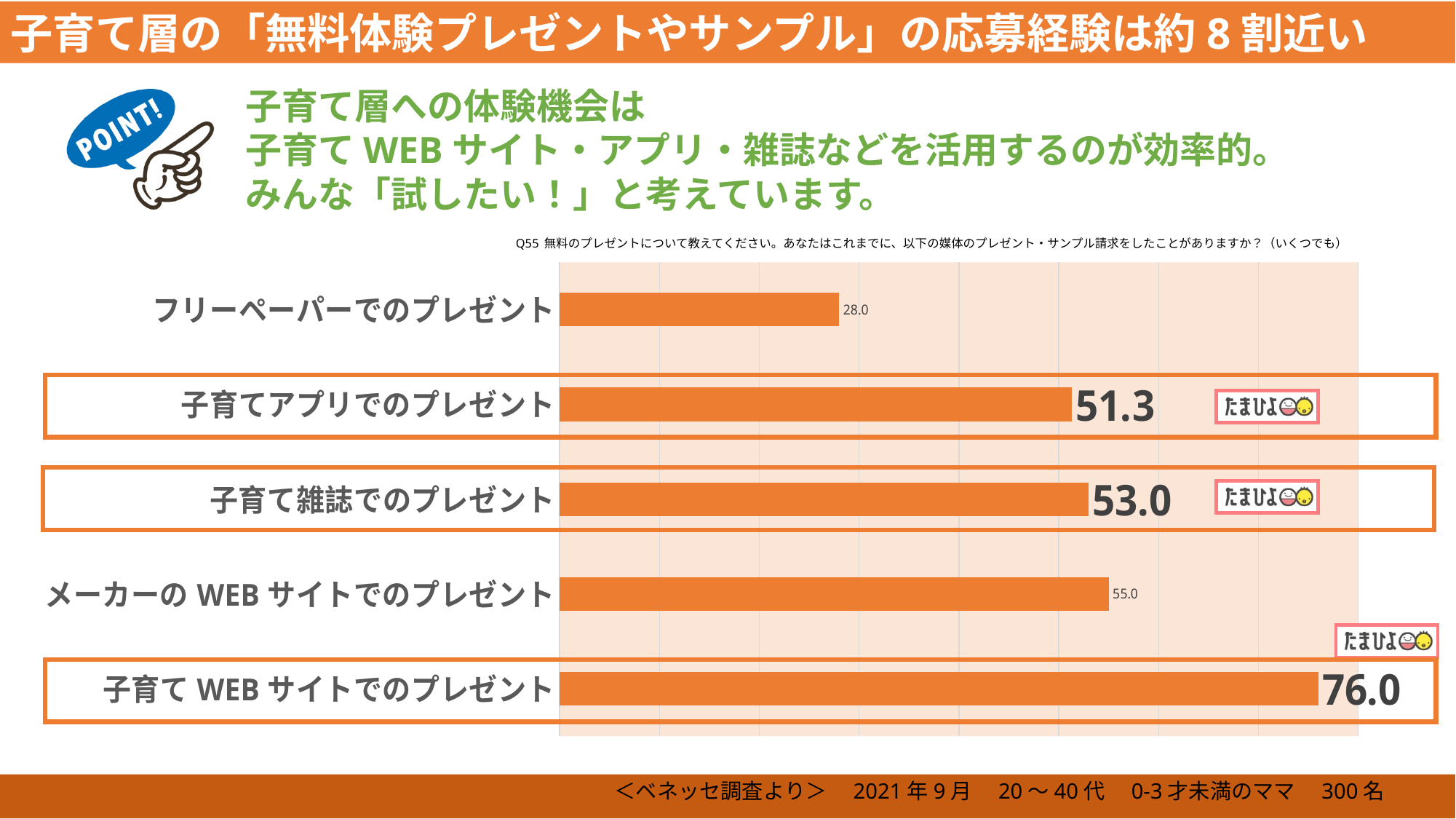
What is the value for 子育て雑誌でのプレゼント? 53.0 What is the value for 子育てWEBサイトでのプレゼント? 76.0 Which category has the lowest value? フリーペーパーでのプレゼント What is the difference between the values for 子育て雑誌でのプレゼント and 子育てアプリでのプレゼント? 1.7 Which is larger, the value for 子育てWEBサイトでのプレゼント or メーカーのWEBサイトでのプレゼント? 子育てWEBサイトでのプレゼント What is the value for 子育てアプリでのプレゼント? 51.3 What is the value for フリーペーパーでのプレゼント? 28.0 How many categories are shown in the chart? 5 Which category has the highest value? 子育てWEBサイトでのプレゼント What is the value for メーカーのWEBサイトでのプレゼント? 55.0 What kind of chart is shown on the slide? Bar chart What is the difference between the values for 子育てWEBサイトでのプレゼント and フリーペーパーでのプレゼント? 48.0